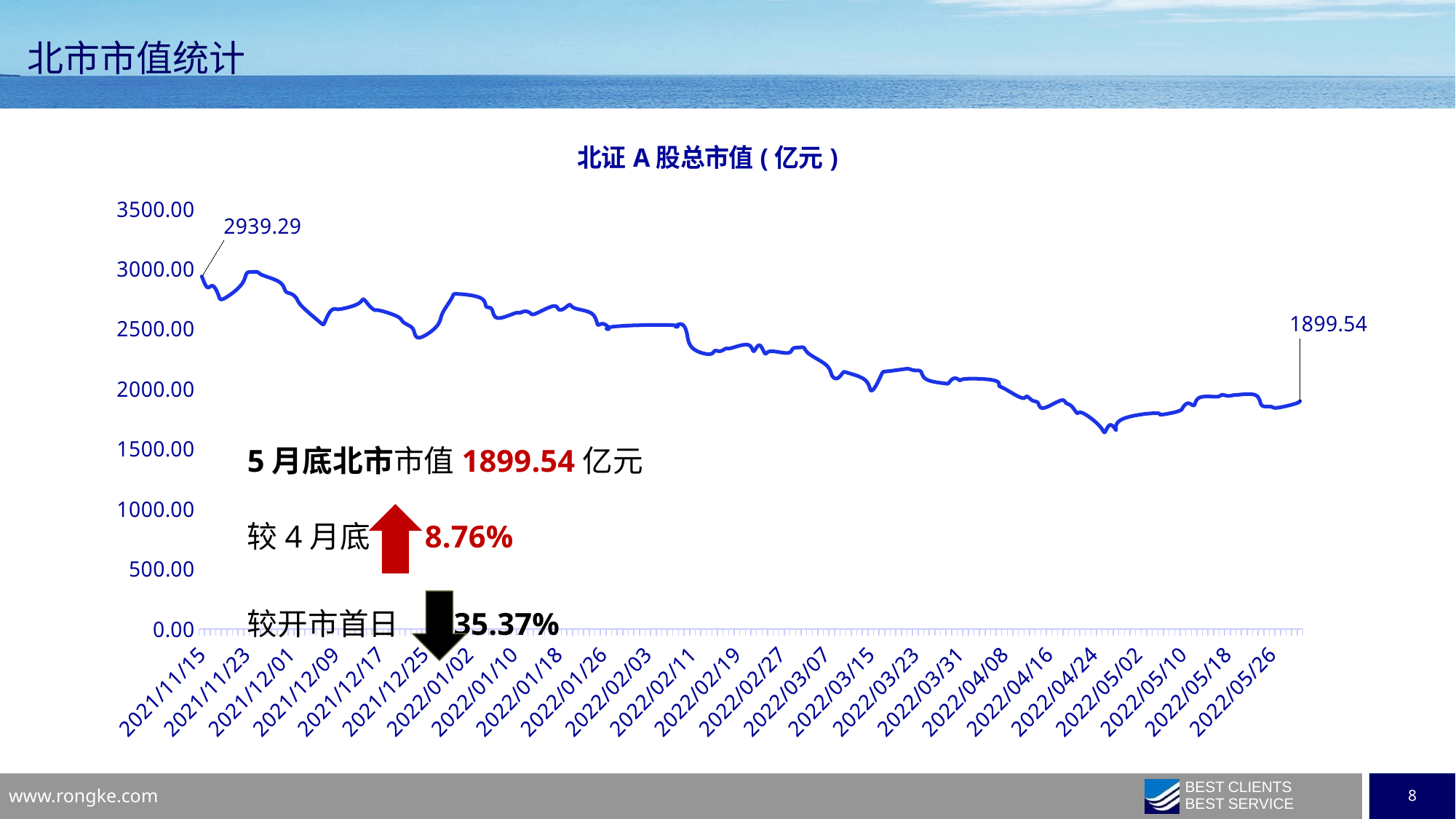
Is the value around 2022/03/07 greater or less than 2500? less Is the value around 2022/01/02 greater or less than 2500? greater Is the value around 2022/04/24 greater or less than 2000? less What is the difference between the first labelled value (2939.29) and the last labelled value (1899.54)? 1039.75 What kind of chart is shown on the slide? line chart What is the data label shown at the last point of the line? 1899.54 What is the data label shown at the first point of the line (2021/11/15)? 2939.29 What is the highest tick value shown on the y axis? 3500.00 What is the title of the chart? 北证A股总市值(亿元) Overall, does the line rise or fall from left to right along the x axis? fall Around which x-axis date does the line reach its lowest point? 2022/04/24 Which is larger, the value at the start of the line (2939.29) or the value at the end of the line (1899.54)? the start value, 2939.29